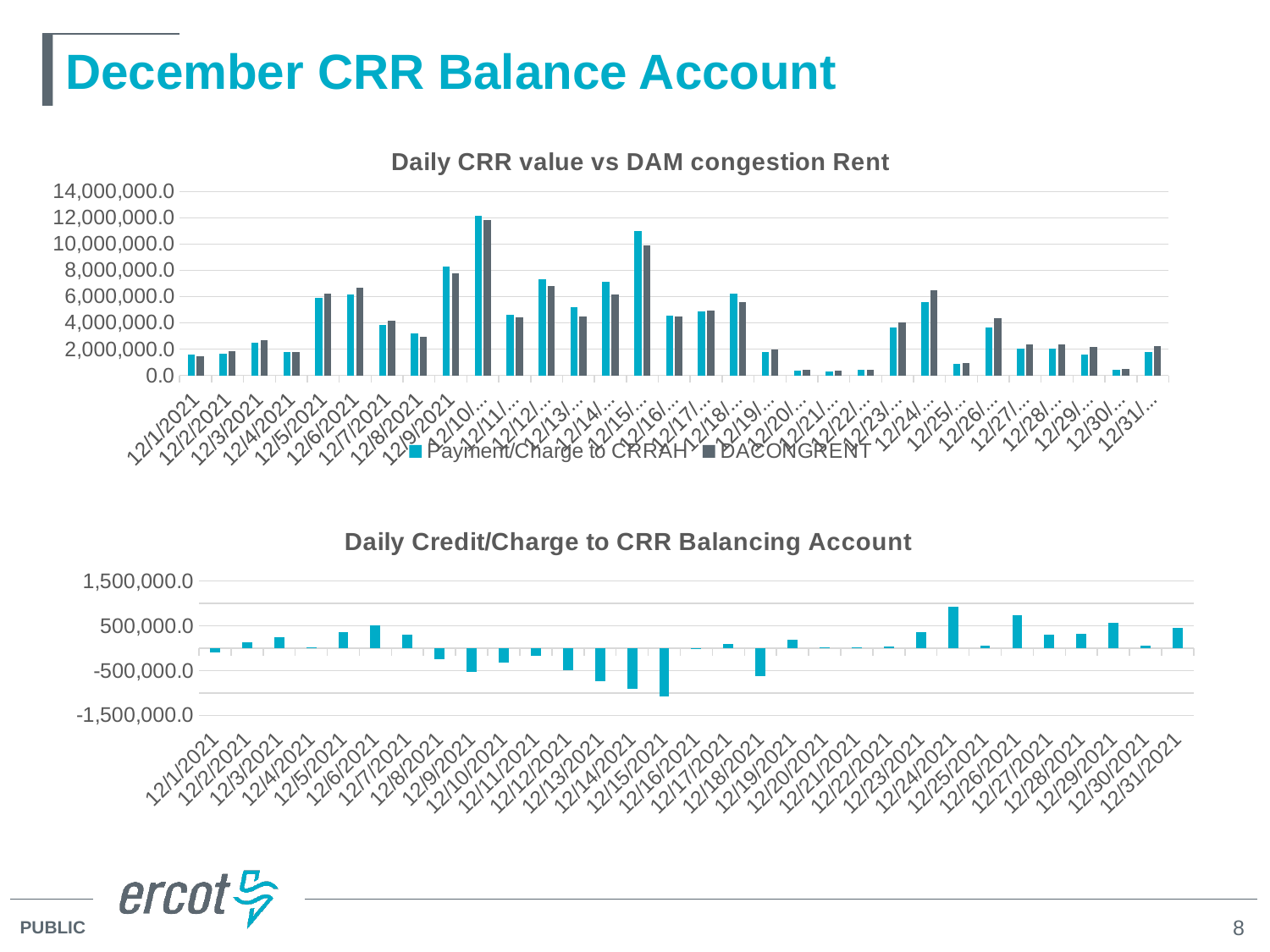
In the top chart, 'Daily CRR value vs DAM congestion Rent', what are the two series named in the legend? Payment/Charge to CRRAH and DACONGRENT In the bottom chart, 'Daily Credit/Charge to CRR Balancing Account', on which date is the value lowest? 12/15/2021 In the top chart, 'Daily CRR value vs DAM congestion Rent', is the Payment/Charge to CRRAH value for 12/15 greater or less than 10,000,000.0? greater In the top chart, 'Daily CRR value vs DAM congestion Rent', which date has the larger Payment/Charge to CRRAH value: 12/10 or 12/15? 12/10 How many series does the legend of the top chart, 'Daily CRR value vs DAM congestion Rent', list? 2 What kind of chart is the bottom chart, 'Daily Credit/Charge to CRR Balancing Account'? Bar chart In the top chart, 'Daily CRR value vs DAM congestion Rent', which is larger on 12/24: Payment/Charge to CRRAH or DACONGRENT? DACONGRENT In the top chart, 'Daily CRR value vs DAM congestion Rent', on which date is the Payment/Charge to CRRAH bar highest? 12/10 What kind of chart is the top chart, 'Daily CRR value vs DAM congestion Rent'? Bar chart In the top chart, 'Daily CRR value vs DAM congestion Rent', is the Payment/Charge to CRRAH value for 12/1/2021 greater or less than 2,000,000.0? less In the bottom chart, 'Daily Credit/Charge to CRR Balancing Account', is the value for 12/14/2021 greater or less than -500,000.0? less In the bottom chart, 'Daily Credit/Charge to CRR Balancing Account', on which date is the value highest? 12/24/2021